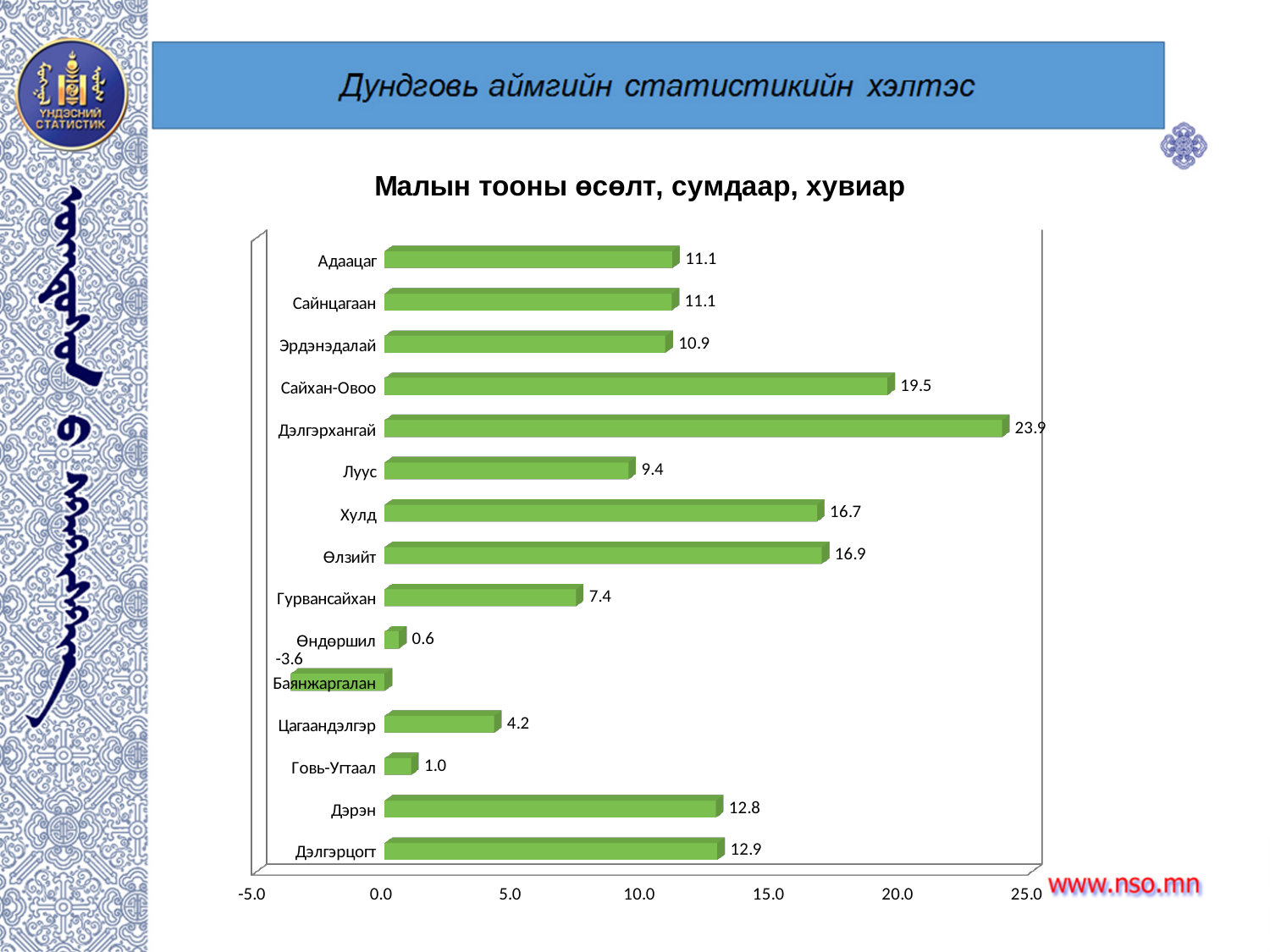
What is the value for Баянжаргалан? -3.6 What is the difference between the values for Дэлгэрхангай and Сайхан-Овоо? 4.4 What kind of chart is shown on the slide? Bar chart Which category has the lowest value? Баянжаргалан Which is larger, the value for Луус or the value for Гурвансайхан? Луус What is the value for Говь-Угтаал? 1.0 What is the value for Сайхан-Овоо? 19.5 Is the value for Өлзийт greater or less than 15.0? greater How many categories are shown in the chart? 15 Which category has the highest value? Дэлгэрхангай What is the value for Хулд? 16.7 What is the title of the chart? Малын тооны өсөлт, сумдаар, хувиар